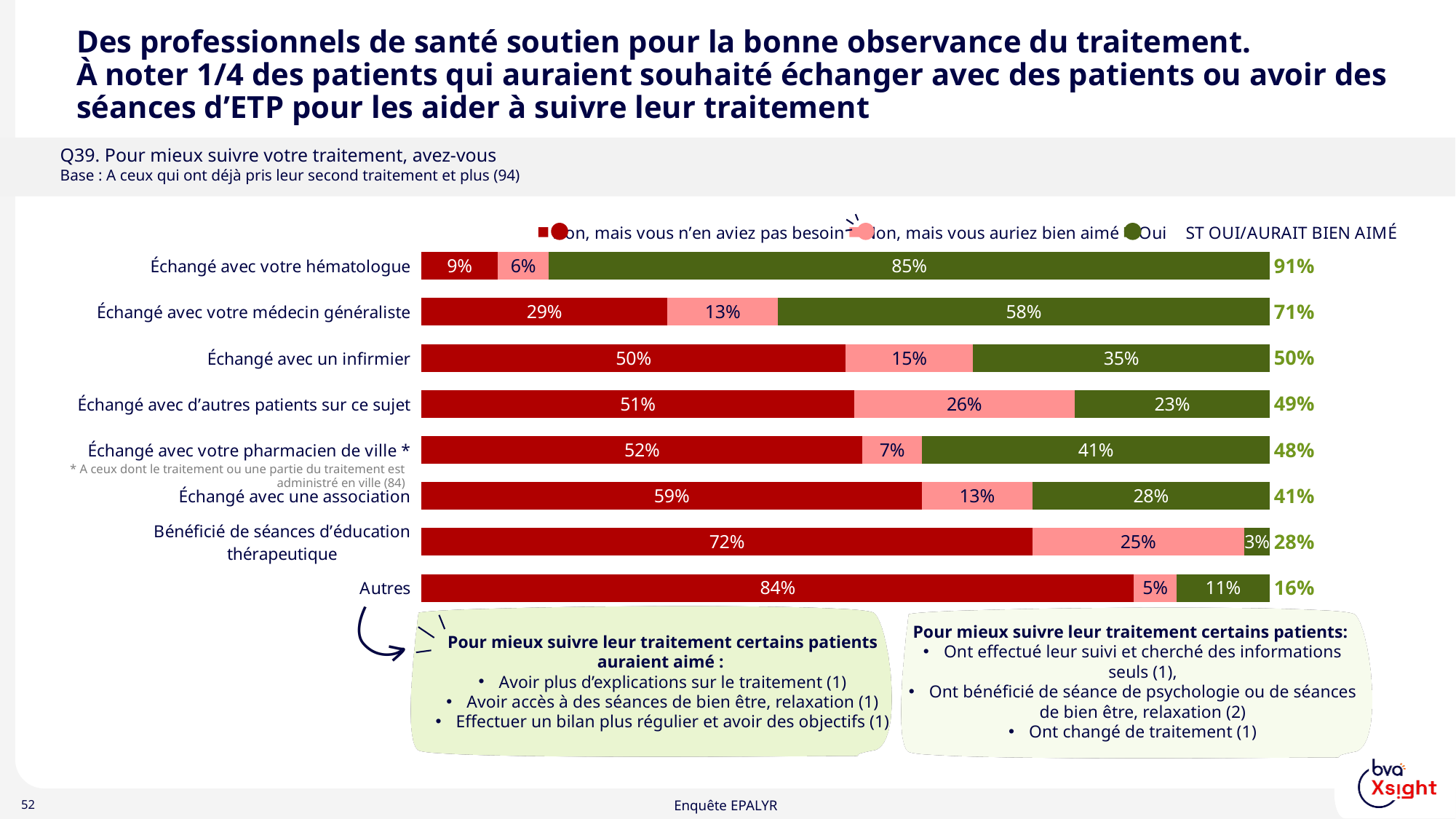
What kind of chart is shown on the slide? Stacked bar chart Which category has the lowest "Oui" value? Bénéficié de séances d'éducation thérapeutique What is the "Non, mais vous n'en aviez pas besoin" value for "Autres"? 84% How many series does the legend list? 4 Which is larger: the "Non, mais vous auriez bien aimé" value for "Échangé avec un infirmier" or for "Échangé avec une association"? Échangé avec un infirmier What is the total of the three segments for "Échangé avec un infirmier"? 100% Which category has the highest "Oui" value? Échangé avec votre hématologue What is the "Non, mais vous auriez bien aimé" value for "Échangé avec d'autres patients sur ce sujet"? 26% What is the difference between the "Oui" values for "Échangé avec votre pharmacien de ville *" and "Échangé avec une association"? 13% What is the "Oui" value for "Échangé avec votre hématologue"? 85% What is the ST OUI/AURAIT BIEN AIMÉ value for "Échangé avec votre médecin généraliste"? 71% How many categories (rows) does the chart show? 8